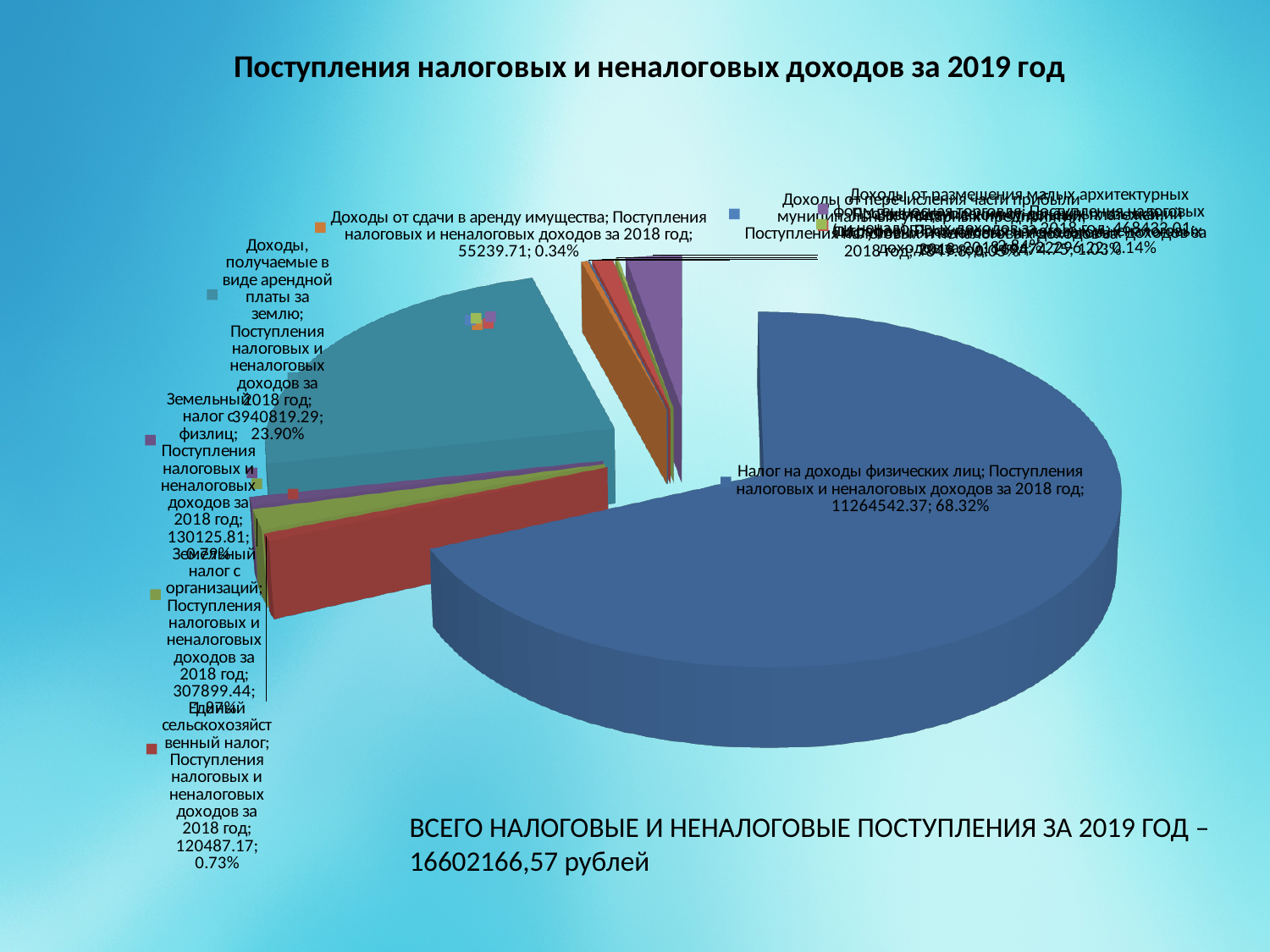
What share of the pie does Доходы от сдачи в аренду имущества represent? 0.34% What kind of chart is shown on the slide? Pie chart What is the value for Единый сельскохозяйственный налог? 120487.17 What is the difference between the values for Налог на доходы физических лиц and Доходы, получаемые в виде арендной платы за землю? 7323723.08 What is the value for Доходы, получаемые в виде арендной платы за землю? 3940819.29 What is the value for Налог на доходы физических лиц? 11264542.37 Which is larger: Земельный налог с физлиц or Земельный налог с организаций? Земельный налог с организаций What share of the pie does Доходы, получаемые в виде арендной платы за землю represent? 23.90% What is the value for Земельный налог с организаций? 307899.44 What share of the pie does Налог на доходы физических лиц represent? 68.32% Which category has the largest slice of the pie? Налог на доходы физических лиц What is the title of the chart? Поступления налоговых и неналоговых доходов за 2019 год